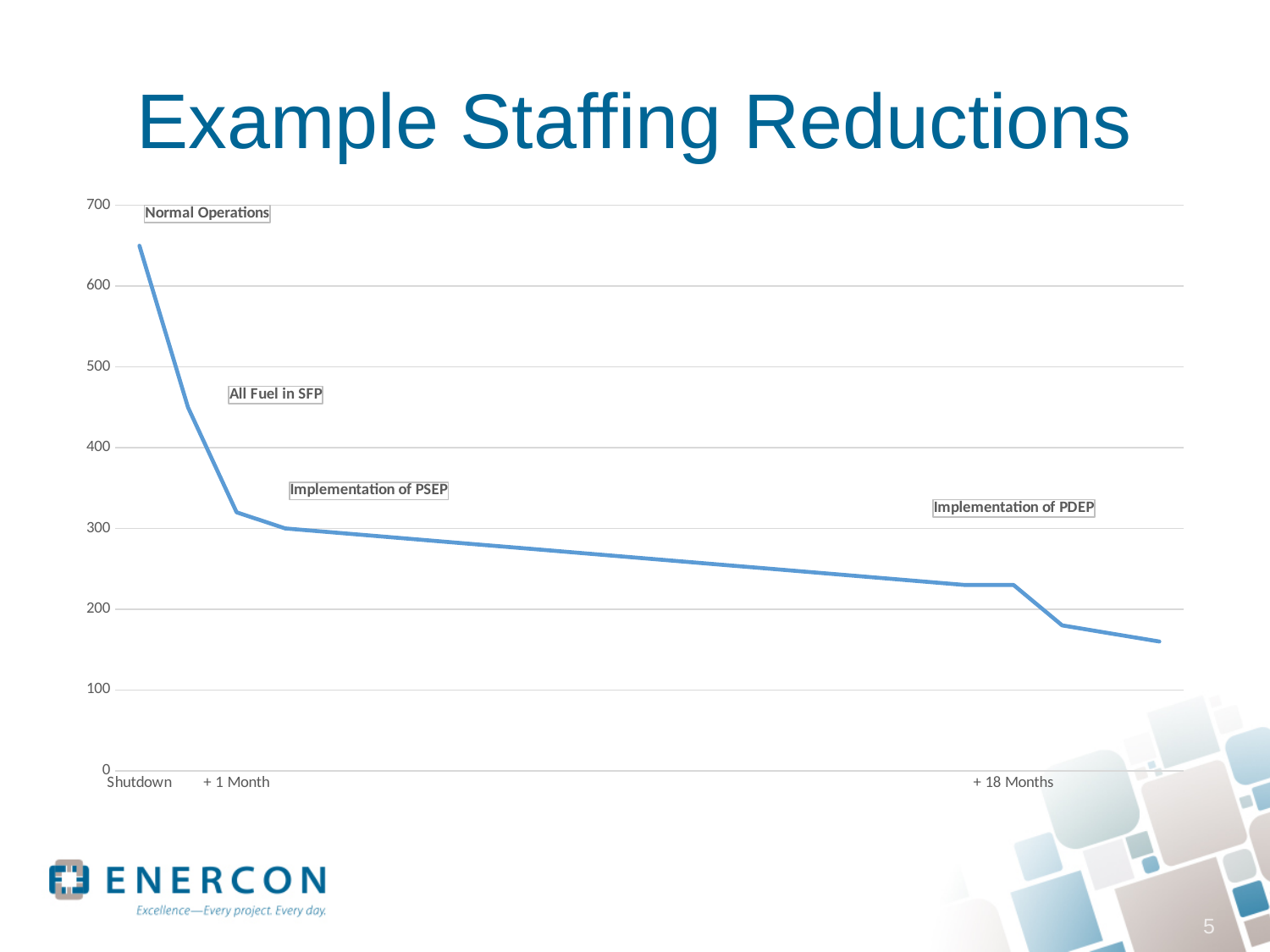
Which annotation on the chart appears just before the first steep drop in the line? Normal Operations Is the value at Shutdown greater or less than 600? greater What is the highest value shown on the y axis? 700 What kind of chart is shown on the slide? line chart Which is larger, the value at Shutdown or the value at + 18 Months? Shutdown How many labeled points are shown on the x axis? 3 What is the title of the chart? Example Staffing Reductions Is the value at + 1 Month greater or less than 400? less Is the value at + 18 Months greater or less than 300? less Do the values rise or fall along the x axis from Shutdown to + 18 Months? fall Which of the labeled points on the x axis has the highest value? Shutdown